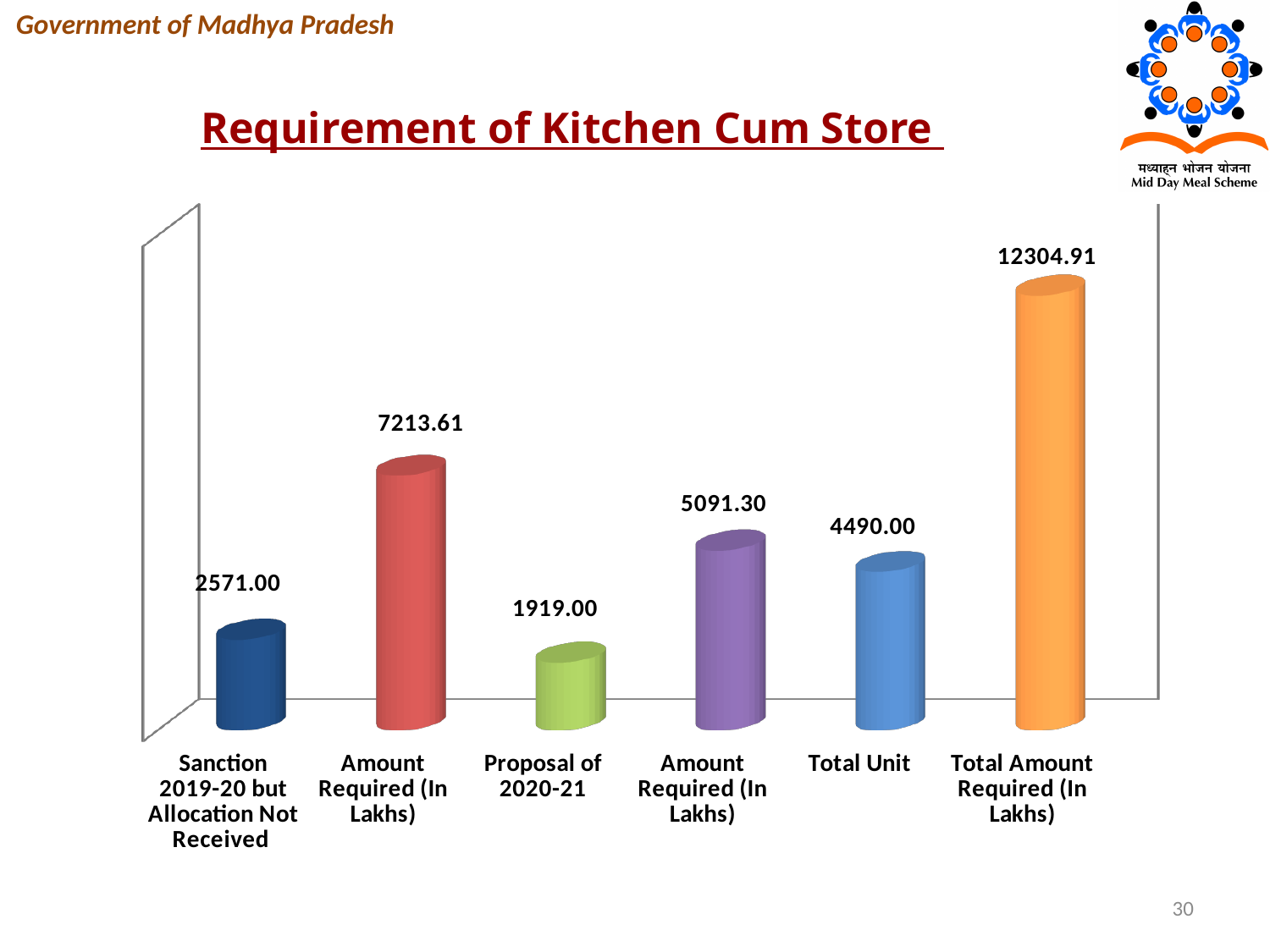
Which is larger, 'Total Unit' or 'Sanction 2019-20 but Allocation Not Received'? Total Unit How many bars are shown in the chart? 6 What is the value for 'Total Amount Required (In Lakhs)'? 12304.91 What type of chart is shown on the slide? Bar chart What is the difference between 'Sanction 2019-20 but Allocation Not Received' and 'Proposal of 2020-21'? 652.00 What is the value for 'Sanction 2019-20 but Allocation Not Received'? 2571.00 What is the value for 'Total Unit'? 4490.00 What is the value of the second bar from the left, labelled 'Amount Required (In Lakhs)'? 7213.61 Which category has the highest value? Total Amount Required (In Lakhs) Which category has the lowest value? Proposal of 2020-21 What is the value for 'Proposal of 2020-21'? 1919.00 What is the difference between 'Total Amount Required (In Lakhs)' and the second bar 'Amount Required (In Lakhs)' (7213.61)? 5091.30